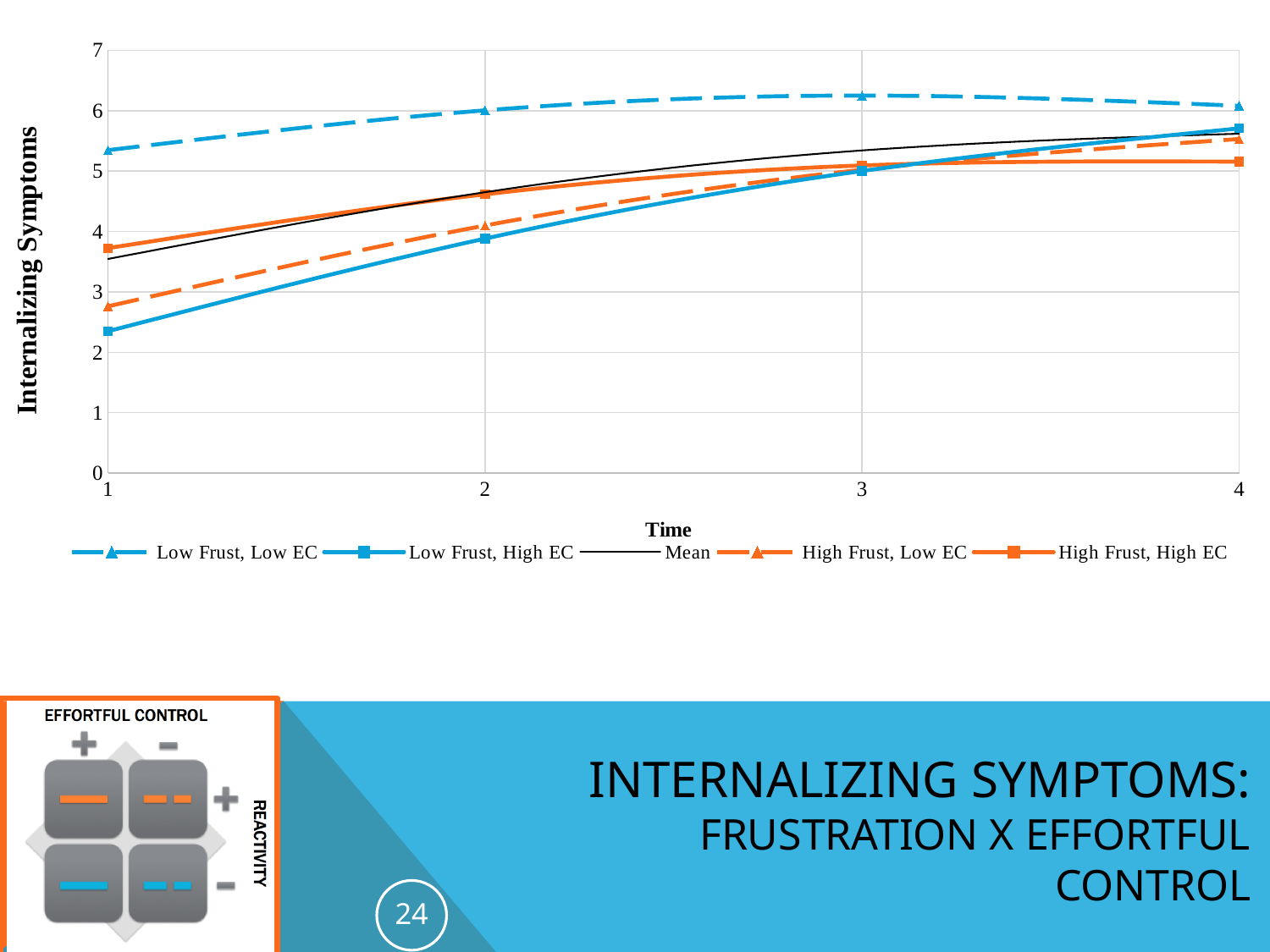
Does the Low Frust, High EC series rise or fall from time 1 to time 4? rise Is the value for Low Frust, Low EC at time 1 greater or less than 5? greater Which series has the lowest value at time 1? Low Frust, High EC What is the label of the y axis? Internalizing Symptoms Is the value for Low Frust, High EC at time 1 greater or less than 3? less How many time points are plotted along the x axis? 4 At time 2, which is larger: Low Frust, Low EC or Low Frust, High EC? Low Frust, Low EC What kind of chart is shown on the slide? line chart Which series has the highest value at time 1? Low Frust, Low EC What is the label of the x axis? Time Is the value for Low Frust, Low EC at time 3 greater or less than 6? greater How many series does the legend list? 5